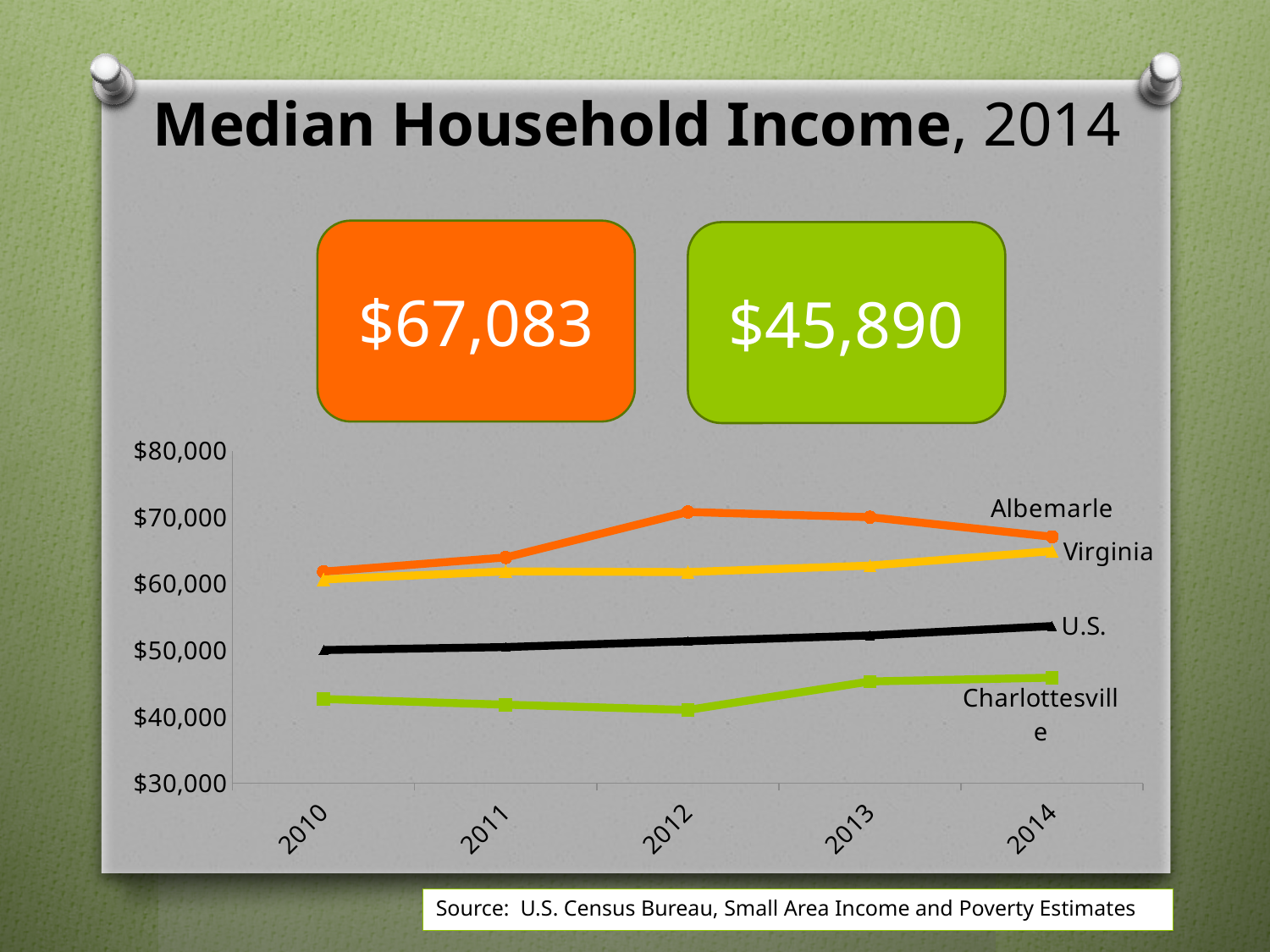
How many series are plotted on the chart? 4 What value is shown in the orange callout box above the chart? $67,083 What kind of chart is shown on the slide? line chart Is the value for Albemarle in 2012 greater or less than $60,000? greater Which series has the highest value in 2012? Albemarle Is the value for U.S. in 2010 greater or less than $60,000? less What value is shown in the green callout box above the chart? $45,890 Is the value for Charlottesville in 2012 greater or less than $50,000? less How many years are shown on the x axis of the chart? 5 Does the U.S. line rise or fall from 2010 to 2014? rise Which series has the lowest value in 2014? Charlottesville In 2014, which is larger: the value for Virginia or the value for U.S.? Virginia